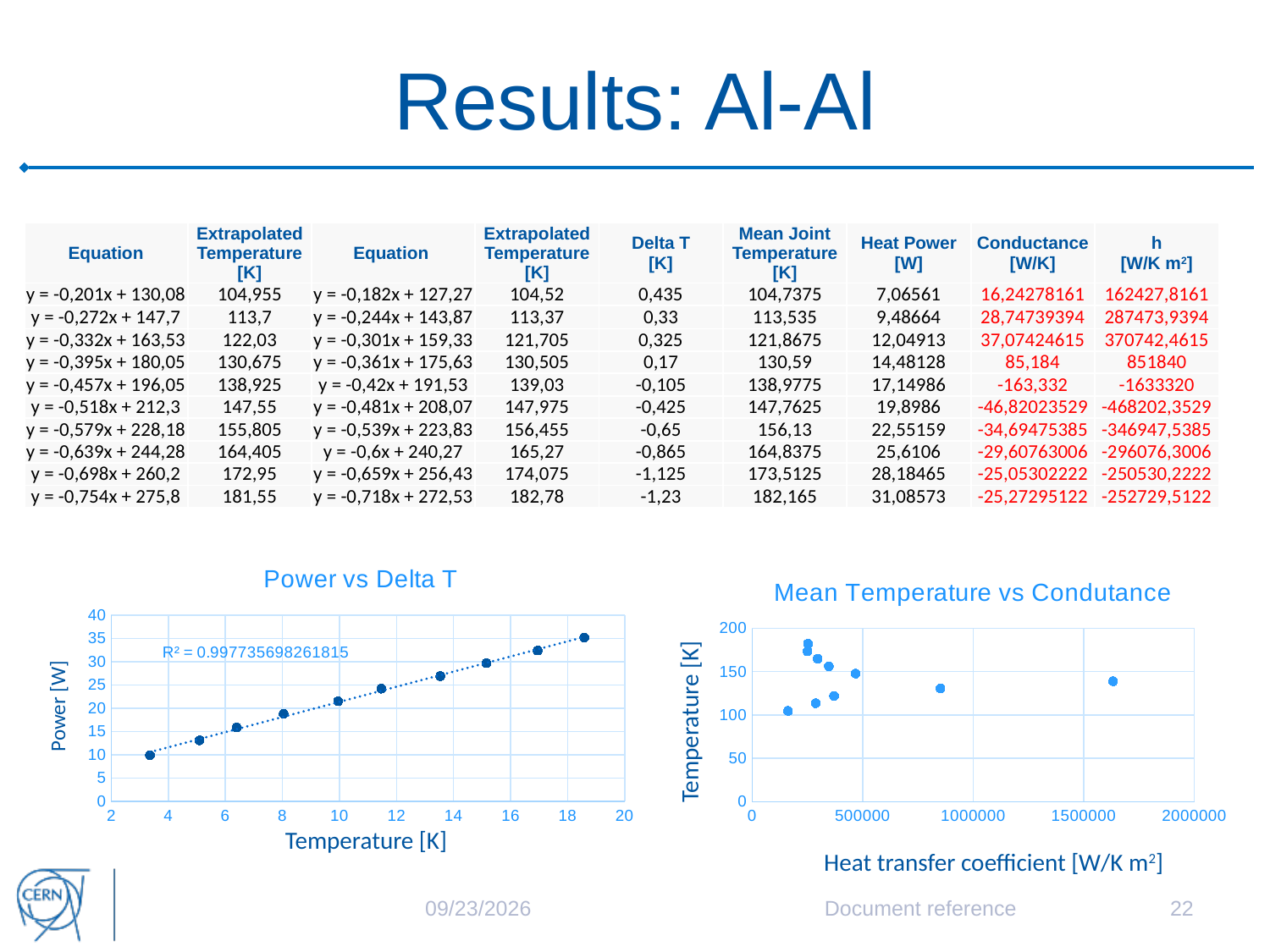
In the "Power vs Delta T" chart, is the power of the rightmost point greater or less than 30? greater What is the x-axis label of the "Power vs Delta T" chart? Temperature [K] In the "Power vs Delta T" chart, is the power of the leftmost point greater or less than 15? less In the "Mean Temperature vs Condutance" chart, is the highest plotted temperature greater or less than 150? greater What kind of chart is the "Power vs Delta T" chart? scatter chart What is the y-axis label of the "Mean Temperature vs Condutance" chart? Temperature [K] In the "Power vs Delta T" chart, how many data points are plotted? 10 What R² value is printed on the "Power vs Delta T" chart? R² = 0.997735698261815 In the "Power vs Delta T" chart, does power rise or fall as temperature increases along the x axis? rise What kind of chart is the "Mean Temperature vs Condutance" chart? scatter chart